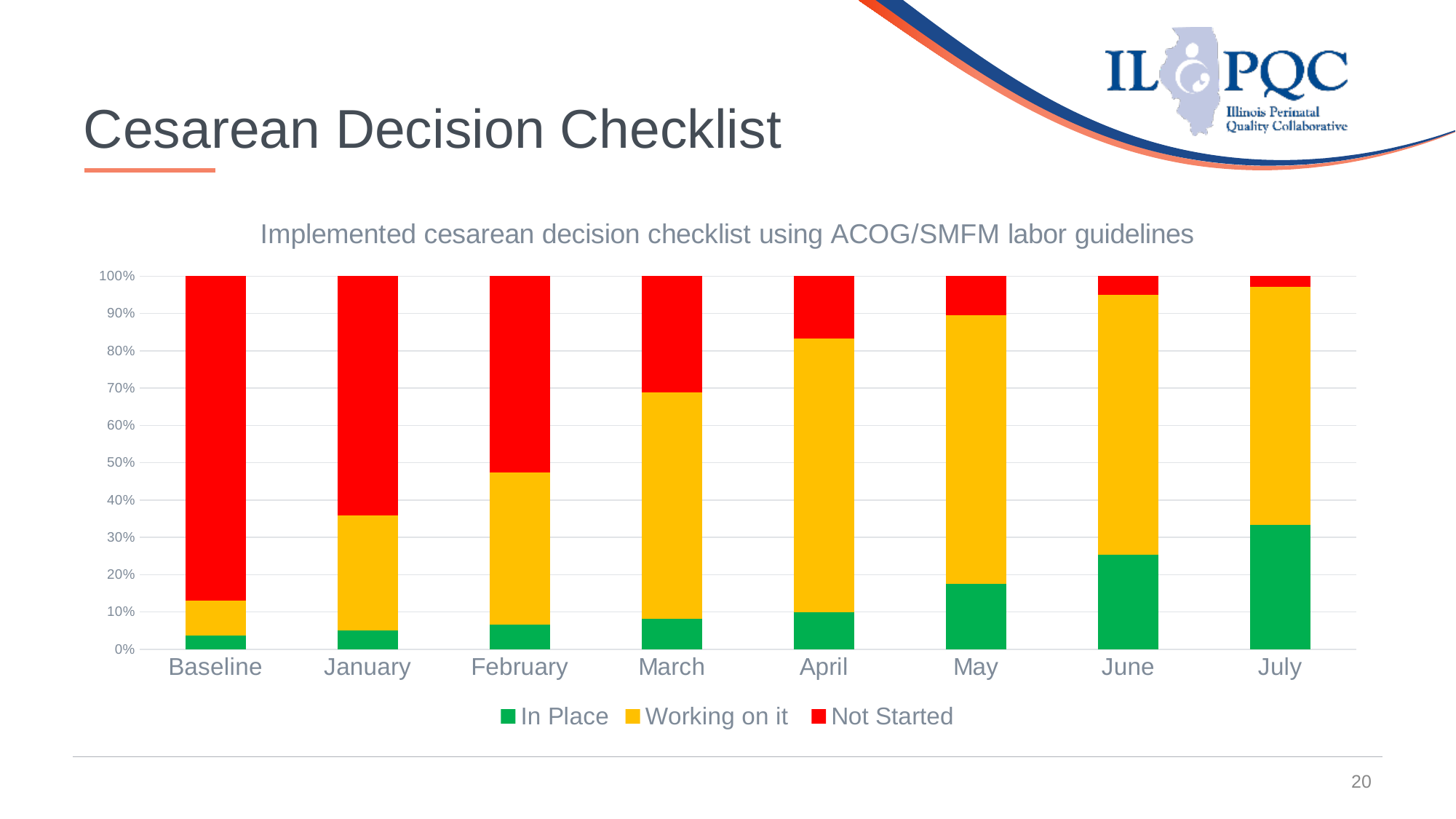
How many categories are shown along the x axis? 8 Which has a larger 'Not Started' share, January or March? January In which category is the 'In Place' share the lowest? Baseline What kind of chart is shown on the slide? Stacked bar chart Is the 'In Place' value for April greater or less than 20%? less In which category is the 'Not Started' share the highest? Baseline Is the 'In Place' value for July greater or less than 30%? greater In which month is the 'In Place' share the highest? July How many series does the legend list? 3 Does the 'Not Started' share rise or fall from Baseline to July? Fall Is the 'Not Started' value for Baseline greater or less than 80%? greater Does the 'In Place' share rise or fall from Baseline to July? Rise